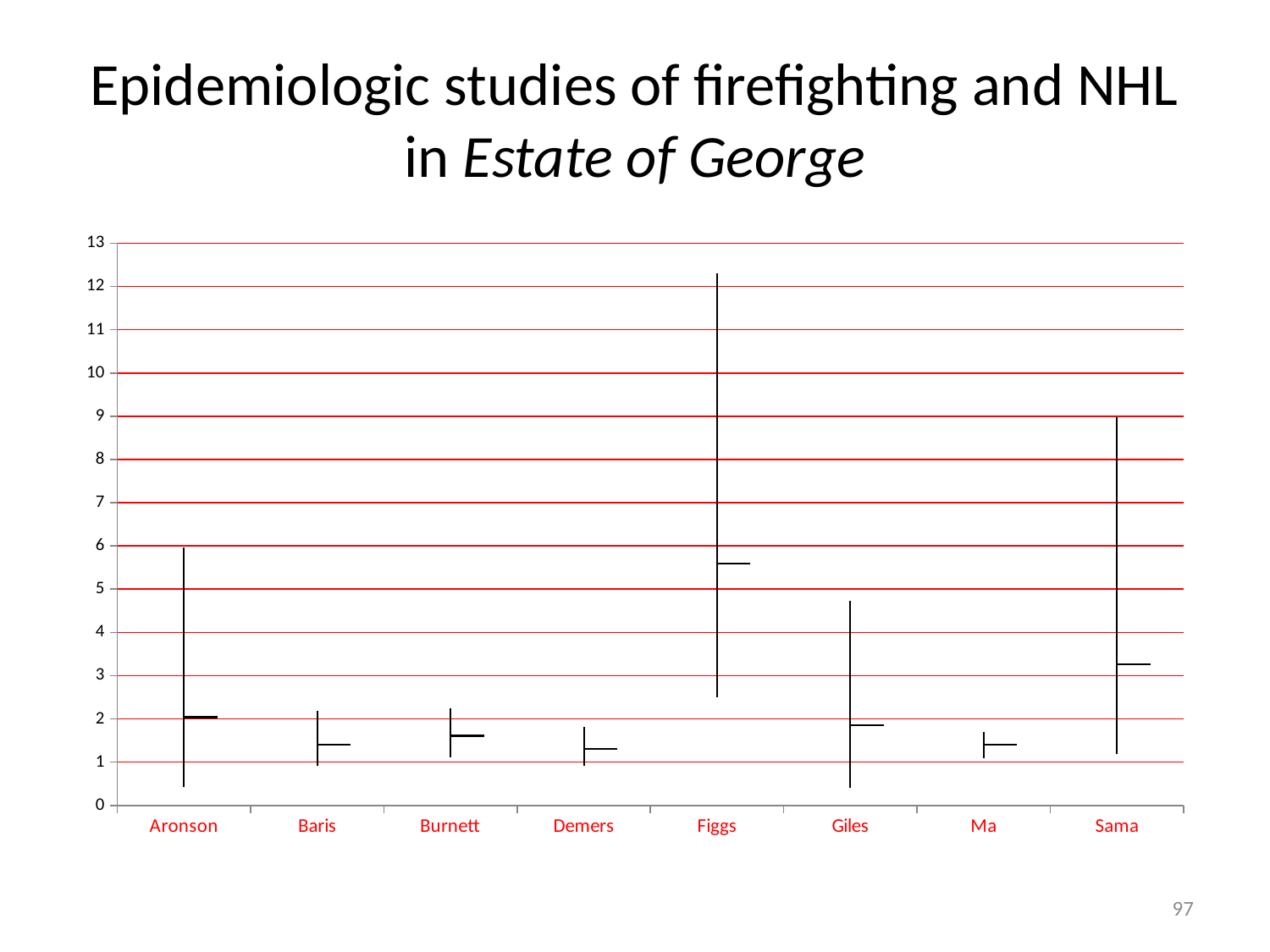
Which study has the highest upper end of its vertical interval line? Figgs How many studies (categories) are shown along the x axis of the chart? 8 What is the maximum value shown on the y axis of the chart? 13 Is the upper end of the interval line for Figgs greater or less than 12? greater Which study has the highest point estimate (horizontal tick) in the chart? Figgs Which has the larger point estimate, Figgs or Sama? Figgs Which has the larger point estimate, Aronson or Baris? Aronson Is the upper end of the interval line for Giles greater or less than 5? less Is the point estimate for Giles greater or less than 2? less What kind of chart is shown on the slide? A high-low (range) chart with point estimates and vertical interval lines